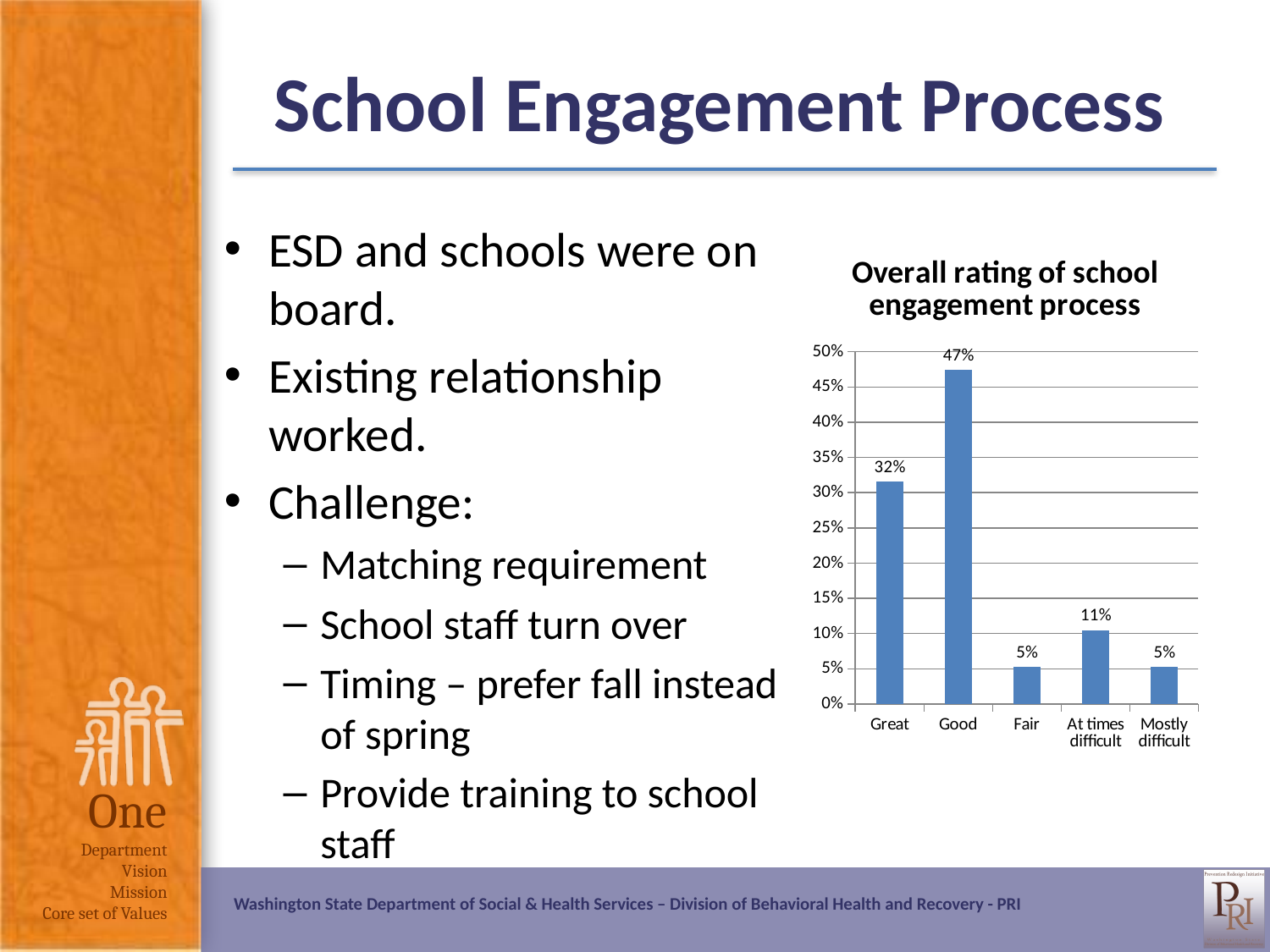
What kind of chart is this? bar chart What is the value for Great? 32% What is the value for At times difficult? 11% Which is larger, the value for Great or the value for At times difficult? Great What is the value for Good? 47% What is the difference between the values for At times difficult and Fair? 6% Which category has the highest value? Good What is the difference between the values for Good and Great? 15% What is the title of the chart? Overall rating of school engagement process How many categories are shown on the x axis? 5 Is the value for Good greater or less than 45%? greater What is the highest value shown on the y axis? 50%